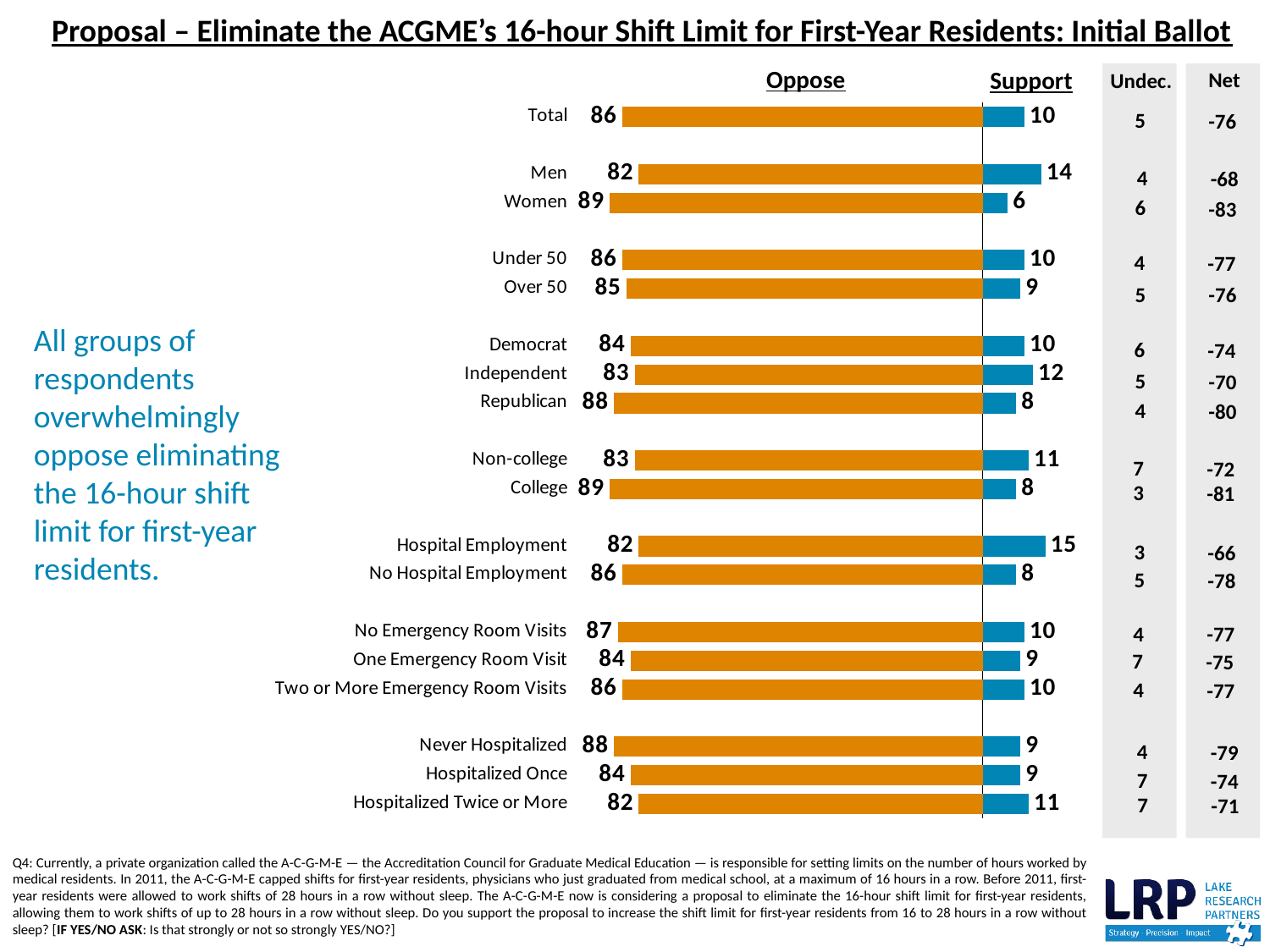
Which category has the highest Support value? Hospital Employment What is the Support value for Hospital Employment? 15 What is the Oppose value for Republican? 88 What is the Support value for Women? 6 What is the difference between the Oppose values for Women and Men? 7 What is the difference between the Oppose and Support values for Total? 76 What type of chart is shown on the slide? Bar chart How many categories are plotted in the chart? 18 What is the Oppose value for Total? 86 Which has a larger Support value, Men or Women? Men Which category has the lowest Support value? Women Which has a larger Oppose value, College or Non-college? College